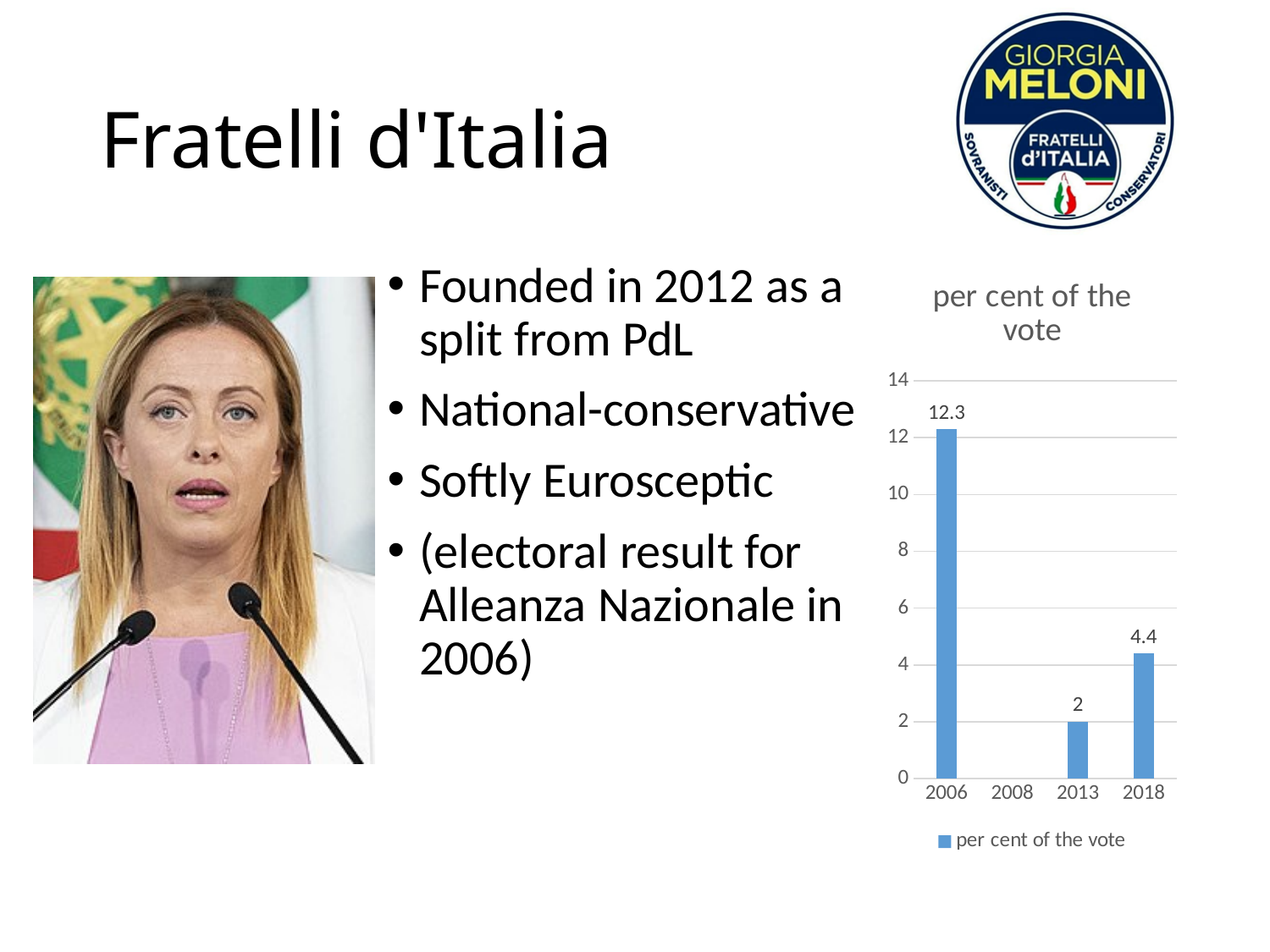
What kind of chart is shown on the slide? bar chart What is the per cent of the vote shown for 2013? 2 How many series does the chart legend list? 1 Is the value for 2006 greater or less than 10? greater What is the difference between the 2006 value and the 2018 value? 7.9 What is the per cent of the vote shown for 2018? 4.4 Which year has the highest per cent of the vote in the chart? 2006 Which year has the larger value, 2013 or 2018? 2018 What is the difference between the 2018 value and the 2013 value? 2.4 How many year labels are shown on the x axis of the chart? 4 What is the per cent of the vote shown for 2006? 12.3 Which year has the shortest plotted bar in the chart? 2013